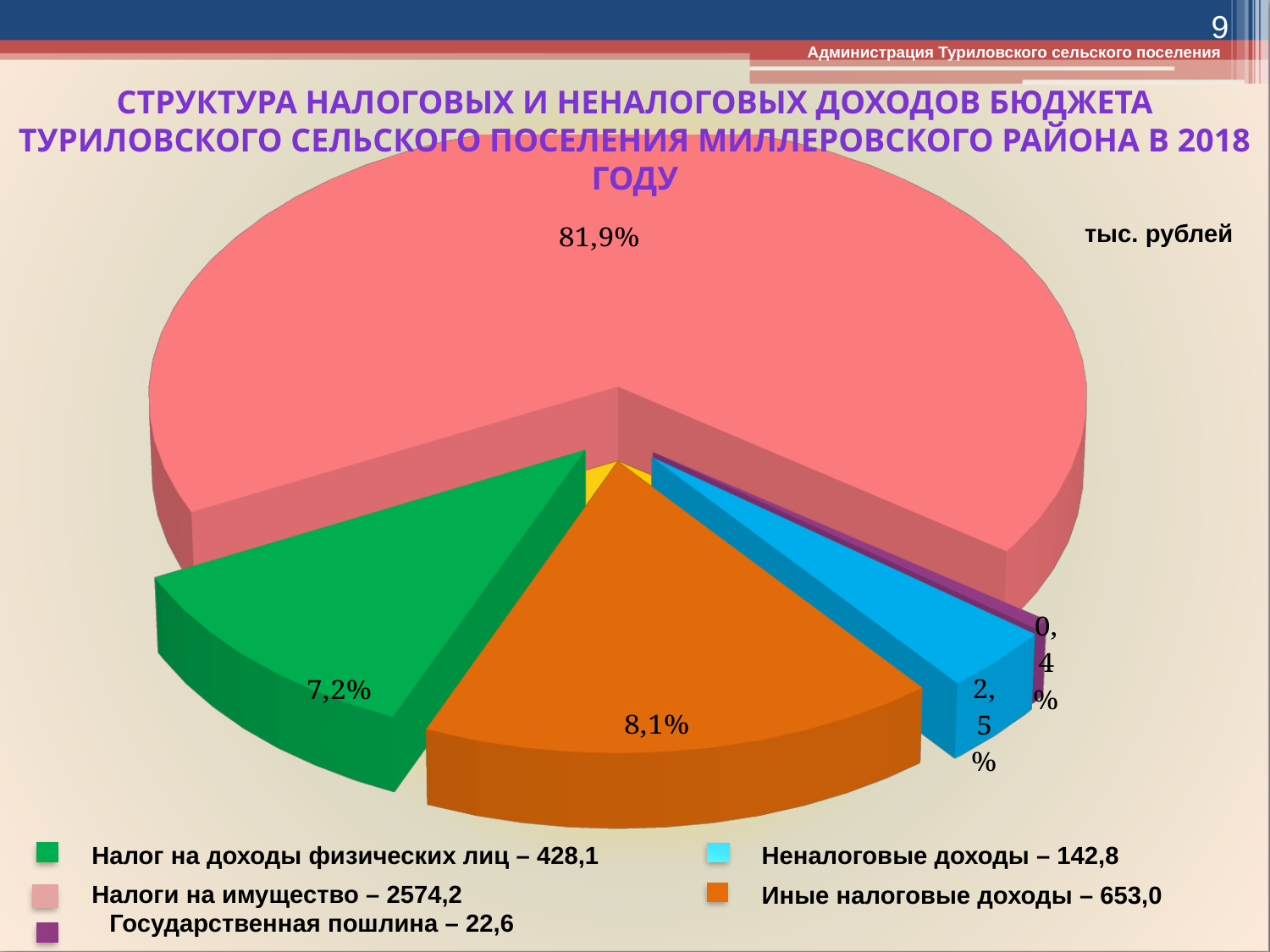
What share of the pie does the slice for Налоги на имущество represent? 81,9% What share of the pie does the slice for Иные налоговые доходы represent? 8,1% What share of the pie does the slice for Неналоговые доходы represent? 2,5% What is the difference in percentage points between the share for Налоги на имущество and the share for Налог на доходы физических лиц? 74,7% Which is larger: the share for Иные налоговые доходы or the share for Налог на доходы физических лиц? Иные налоговые доходы Which category has the smallest share among the labelled slices? Государственная пошлина What is the value shown in the legend for Иные налоговые доходы? 653,0 What is the value shown in the legend for Неналоговые доходы? 142,8 Which category has the largest slice of the pie? Налоги на имущество What kind of chart is shown on the slide? Pie chart